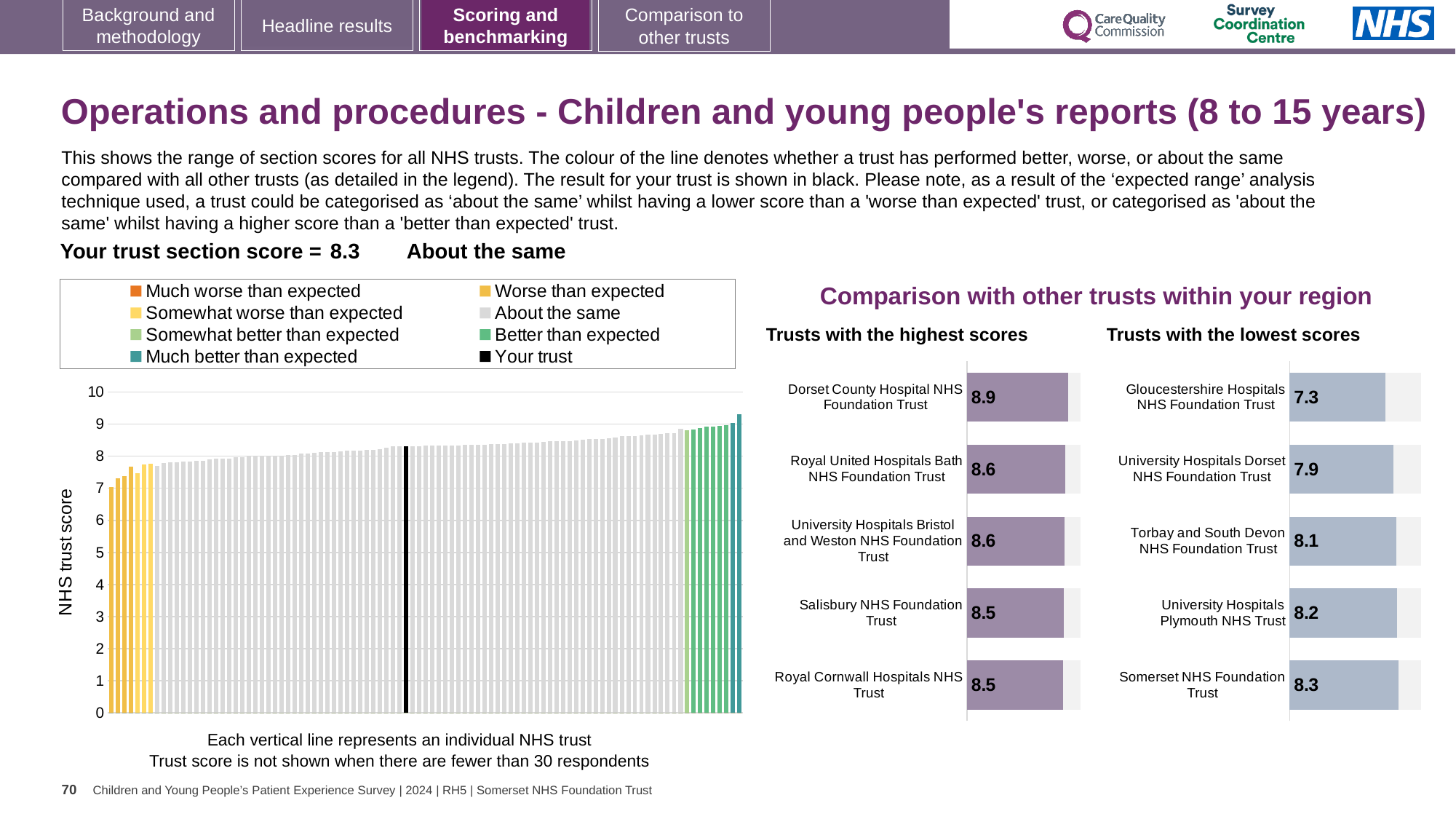
How many entries does the legend above the large chart on the left list? 8 In the 'Trusts with the highest scores' chart, what is the score for Salisbury NHS Foundation Trust? 8.5 In the 'Trusts with the lowest scores' chart, which trust has the lowest score? Gloucestershire Hospitals NHS Foundation Trust What kind of chart is the large chart on the left with the y-axis labelled 'NHS trust score'? bar chart In the 'Trusts with the highest scores' chart, what is the score for Dorset County Hospital NHS Foundation Trust? 8.9 How many trusts are shown in the 'Trusts with the highest scores' chart? 5 In the 'Trusts with the lowest scores' chart, what is the score for Gloucestershire Hospitals NHS Foundation Trust? 7.3 In the large chart on the left, is the value for the black 'Your trust' bar greater or less than 8? greater In the 'Trusts with the lowest scores' chart, what is the score for Somerset NHS Foundation Trust? 8.3 In the 'Trusts with the highest scores' chart, which trust has the highest score? Dorset County Hospital NHS Foundation Trust In the 'Trusts with the lowest scores' chart, which has the higher score: Torbay and South Devon NHS Foundation Trust or University Hospitals Dorset NHS Foundation Trust? Torbay and South Devon NHS Foundation Trust In the 'Trusts with the lowest scores' chart, what is the difference between the scores of Somerset NHS Foundation Trust and Gloucestershire Hospitals NHS Foundation Trust? 1.0